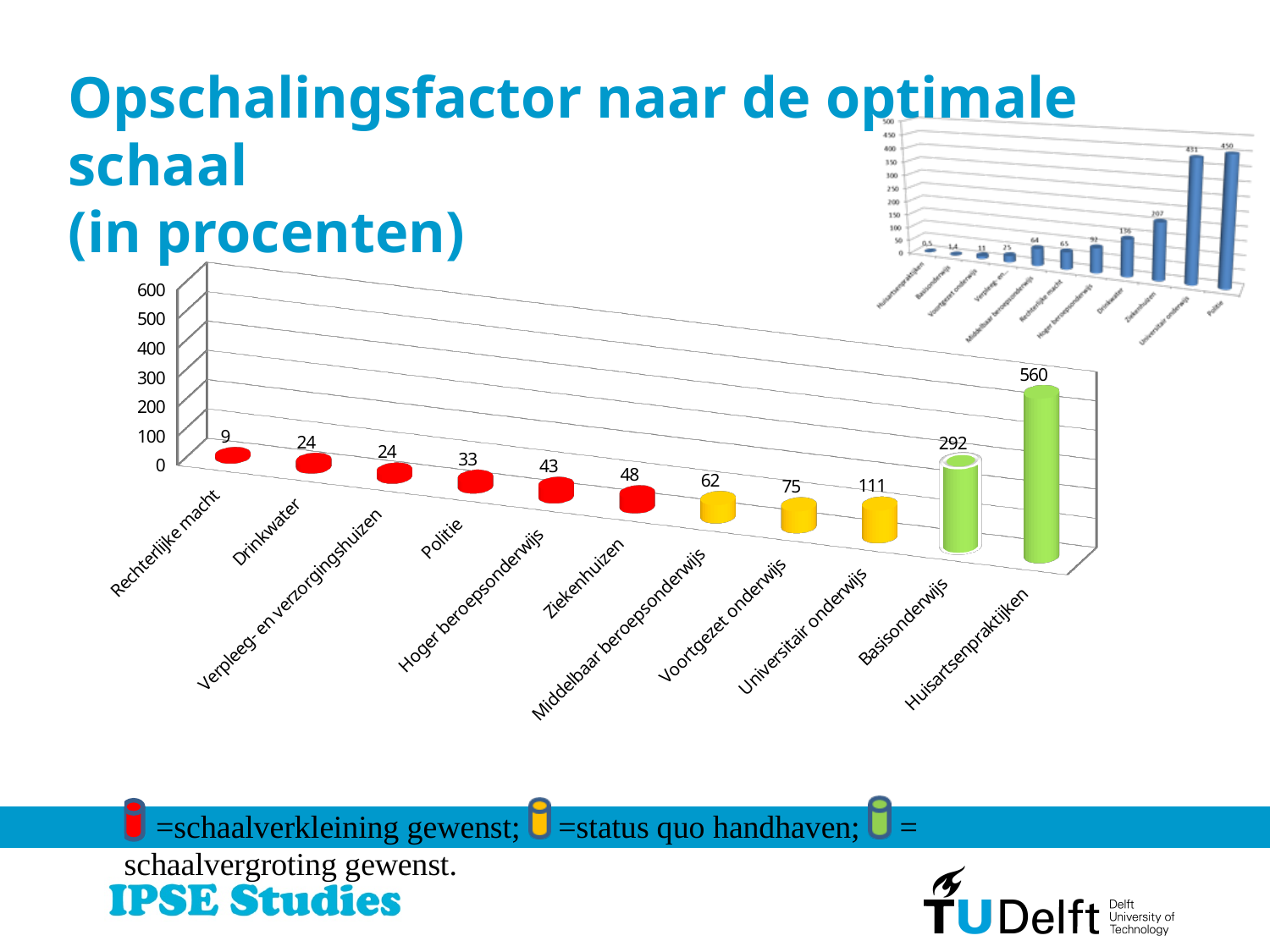
In the large chart, what is the value for Voortgezet onderwijs? 75 In the large chart, is the value for Basisonderwijs greater or less than 200? greater In the large chart, what is the value for Huisartsenpraktijken? 560 What kind of chart is the large chart on the slide? bar chart In the large chart, which category has the highest value? Huisartsenpraktijken In the large chart, which is larger: the value for Ziekenhuizen or the value for Hoger beroepsonderwijs? Ziekenhuizen In the large chart, which category has the lowest value? Rechterlijke macht In the large chart, do the values rise or fall from left to right along the x axis? rise In the large chart, what is the value for Politie? 33 In the large chart, what is the difference between the values for Huisartsenpraktijken and Basisonderwijs? 268 How many categories are shown in the large chart? 11 In the large chart, what is the value for Universitair onderwijs? 111